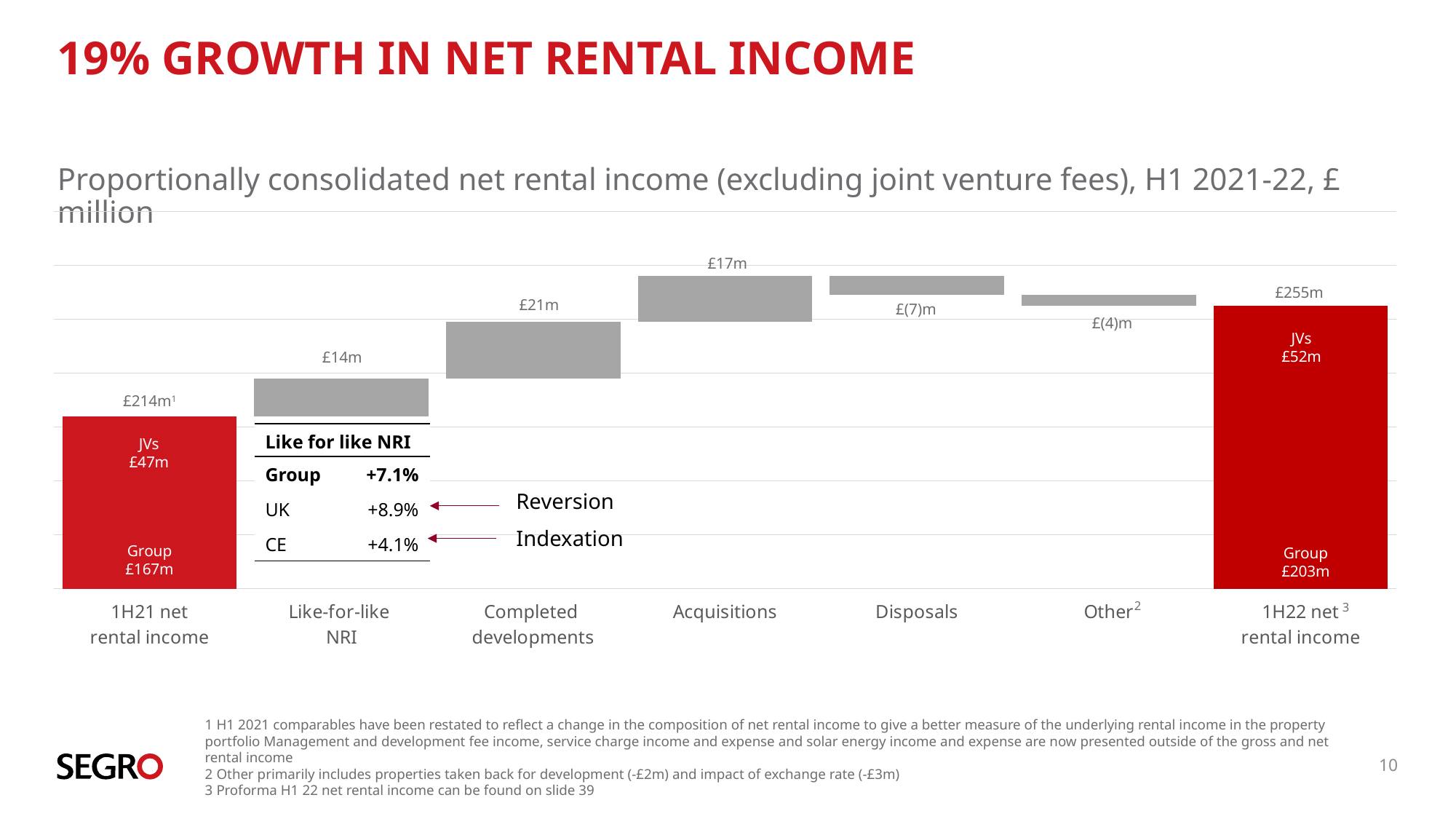
How many categories are shown along the x axis of the chart? 7 What is the difference between the 1H22 net rental income and the 1H21 net rental income? £41m What is the value shown for Acquisitions? £17m What is the JVs portion of the 1H21 net rental income bar? £47m Which is larger, the Like-for-like NRI contribution or the Acquisitions contribution? Acquisitions What is the Group like-for-like NRI growth percentage shown in the table on the chart? +7.1% Which of the positive movement bars (Like-for-like NRI, Completed developments, Acquisitions) is the largest? Completed developments What is the total 1H22 net rental income shown on the chart? £255m What is the value shown for Disposals? £(7)m What is the Group portion of the 1H22 net rental income bar? £203m What is the value shown for Completed developments? £21m What kind of chart is shown on the slide? Waterfall bar chart